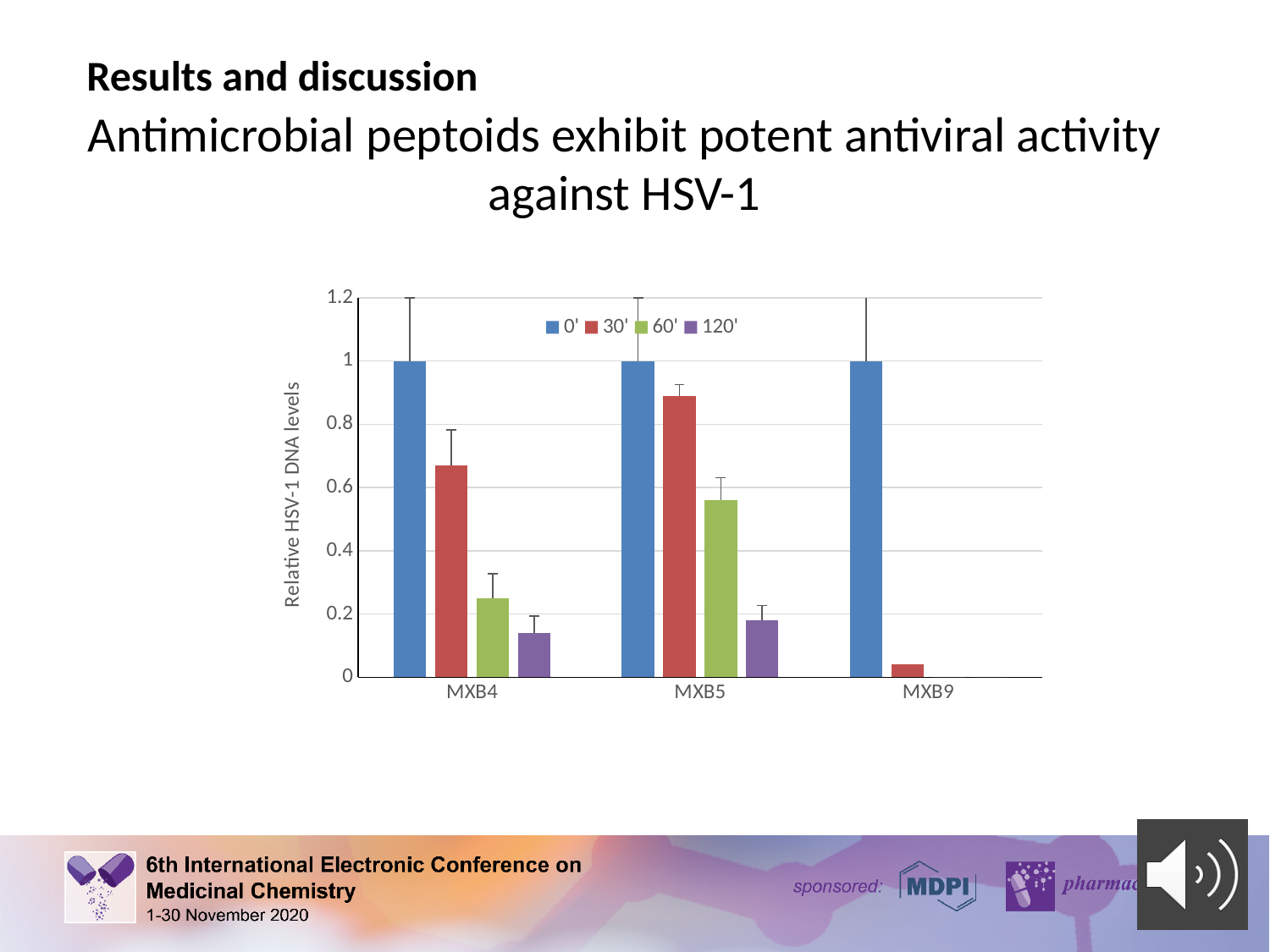
What is the value of the 0' series for MXB9? 1 How many series does the legend list? 4 What is the value of the 0' series for MXB4? 1 What is the y-axis title of the chart? Relative HSV-1 DNA levels Is the value of the 120' series for MXB4 greater or less than 0.2? less Is the value of the 30' series for MXB5 greater or less than 0.8? greater Which category has the lowest value for the 30' series? MXB9 What kind of chart is shown on the slide? Bar chart How many categories are shown on the x axis? 3 Is the value of the 30' series for MXB4 greater or less than 0.6? greater For the 60' series, which is larger: MXB4 or MXB5? MXB5